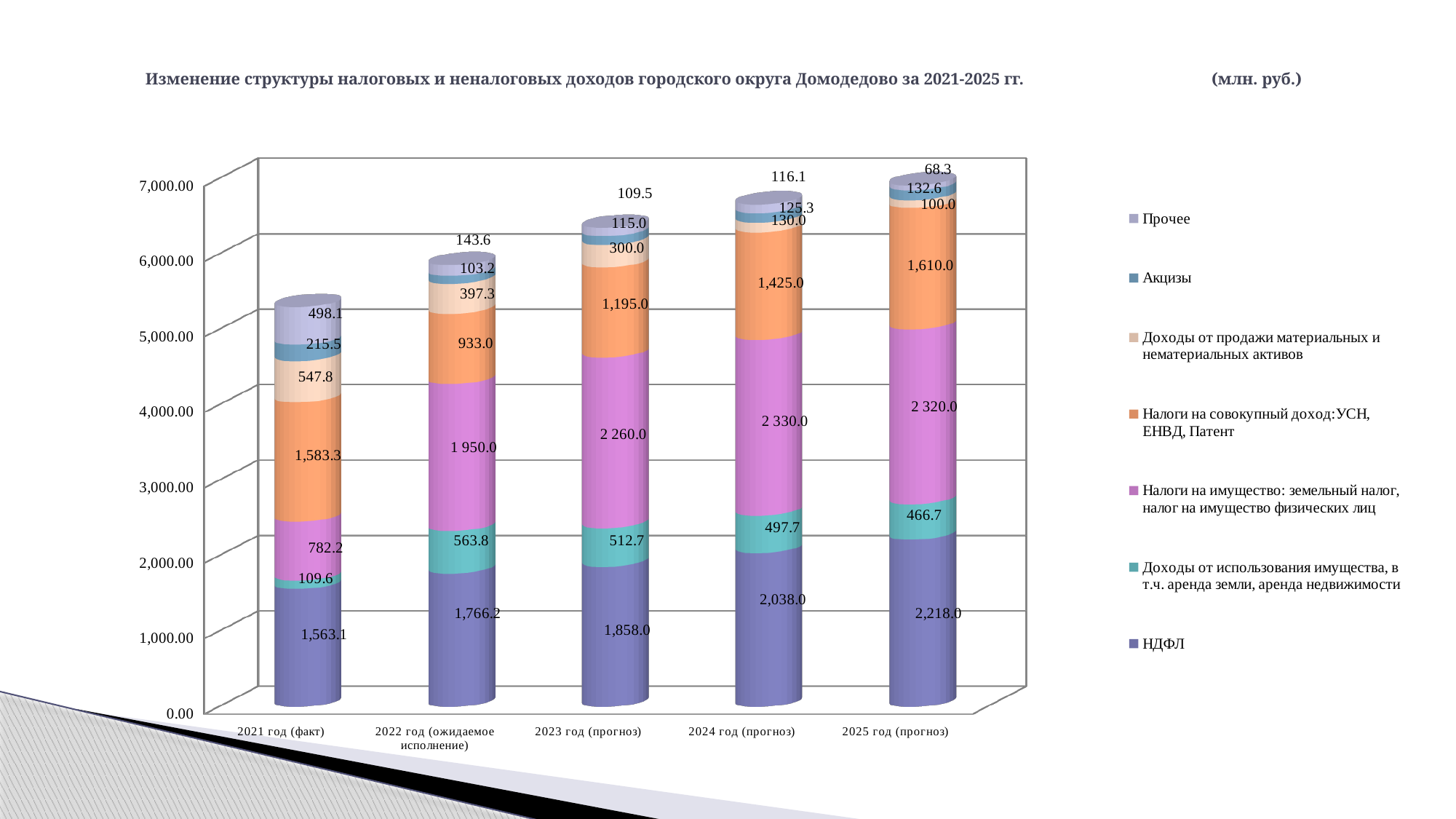
In which year is the Прочее value the lowest? 2025 год (прогноз) What is the value of Налоги на имущество for 2023 год (прогноз)? 2 260.0 What is the total of the stacked bar for 2021 год (факт)? 5,299.6 How many years (categories) are shown on the x axis? 5 How many series does the legend list? 7 What type of chart is shown on the slide? Stacked bar chart What is the difference between the НДФЛ value for 2025 год (прогноз) and for 2021 год (факт)? 654.9 Which is larger for 2022 год: Налоги на совокупный доход or Доходы от продажи материальных и нематериальных активов? Налоги на совокупный доход Does the НДФЛ value rise or fall from 2021 to 2025? Rises What is the value of Акцизы for 2024 год (прогноз)? 125.3 In which year is the НДФЛ value the highest? 2025 год (прогноз) What is the value of НДФЛ for 2021 год (факт)? 1,563.1